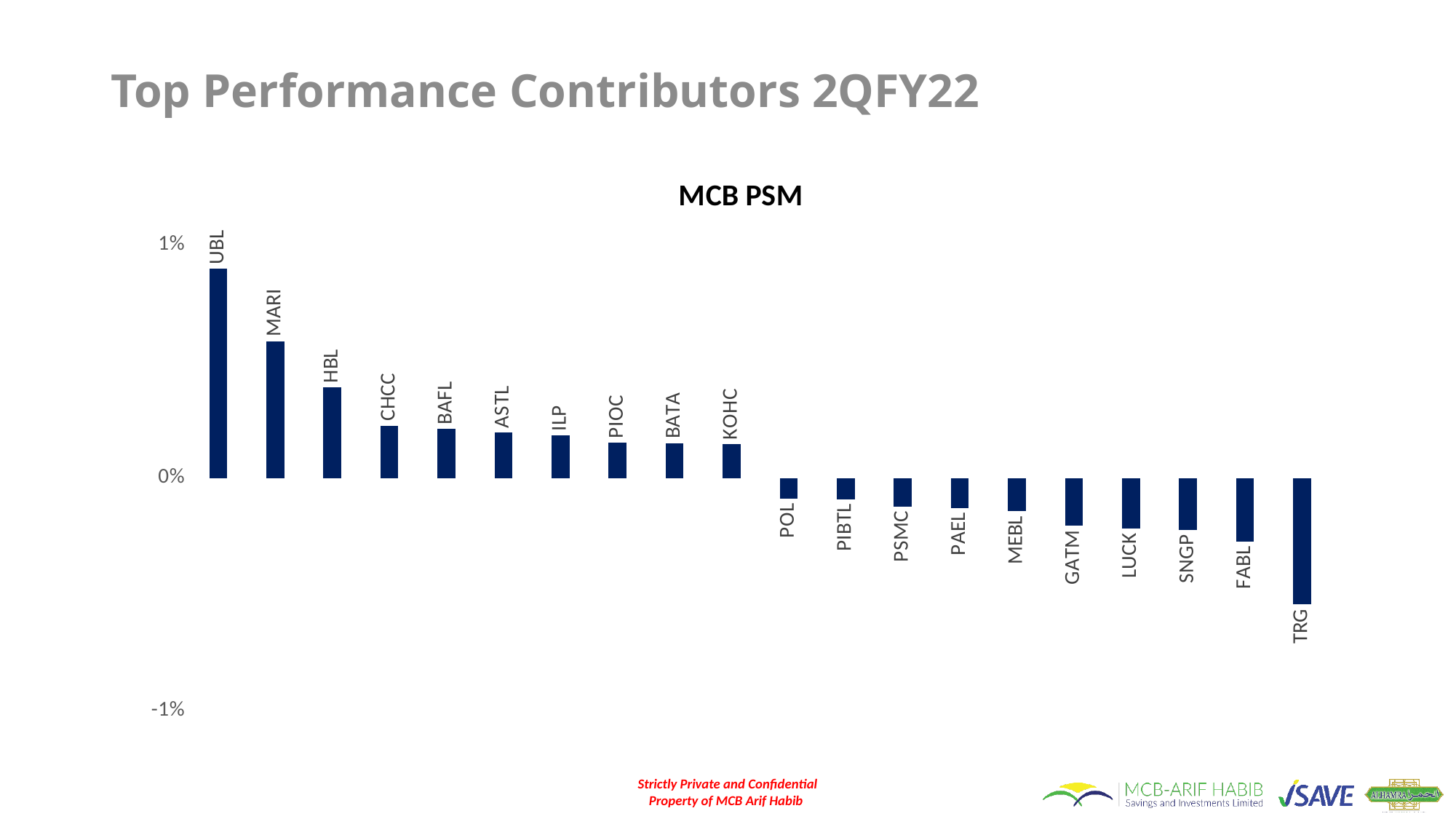
Which category has the highest value in the chart? UBL Do the values rise or fall moving from left to right along the x axis? fall Which has the larger value, HBL or CHCC? HBL How many categories have negative values in the chart? 10 Which has the larger value, UBL or MARI? UBL How many categories (bars) are plotted in the chart? 20 What kind of chart is shown on the slide? bar chart Is the value for TRG greater or less than 0%? less Is the value for KOHC greater or less than 0%? greater Is the value for UBL greater or less than 1%? less Which category has the lowest value in the chart? TRG What is the title of the chart? MCB PSM